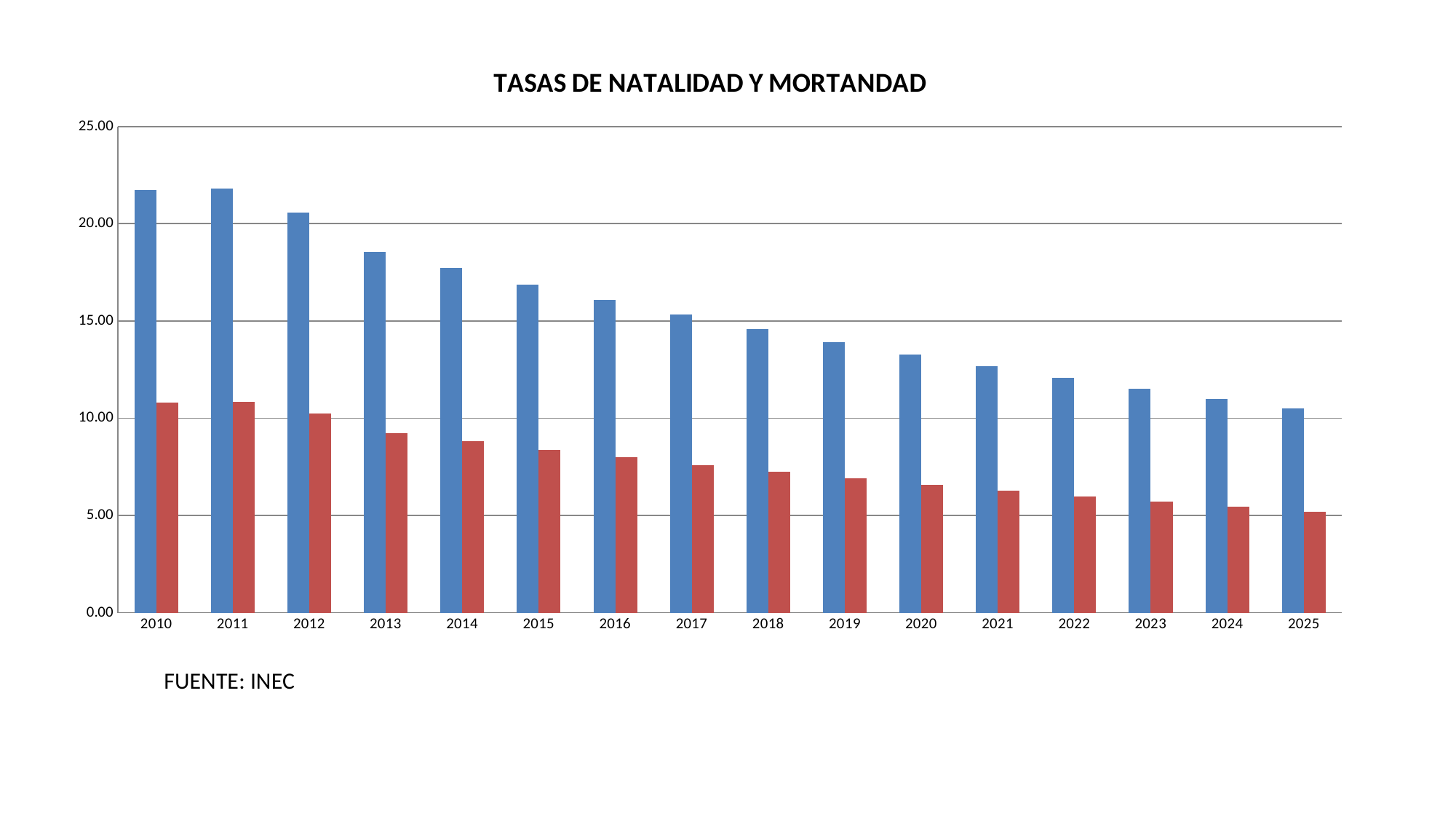
Is the value of the red bar for 2020 greater or less than 5.00? greater Is the value of the blue bar for 2018 greater or less than 15.00? less In 2015, which bar is larger, the blue bar or the red bar? the blue bar In which year is the red bar lowest? 2025 What is the title of the chart? TASAS DE NATALIDAD Y MORTANDAD Is the value of the red bar for 2013 greater or less than 10.00? less Do the red bars rise or fall from 2010 to 2025? fall What kind of chart is shown on the slide? bar chart How many years are shown on the x axis of the chart? 16 Do the blue bars rise or fall from 2010 to 2025? fall In which year is the blue bar lowest? 2025